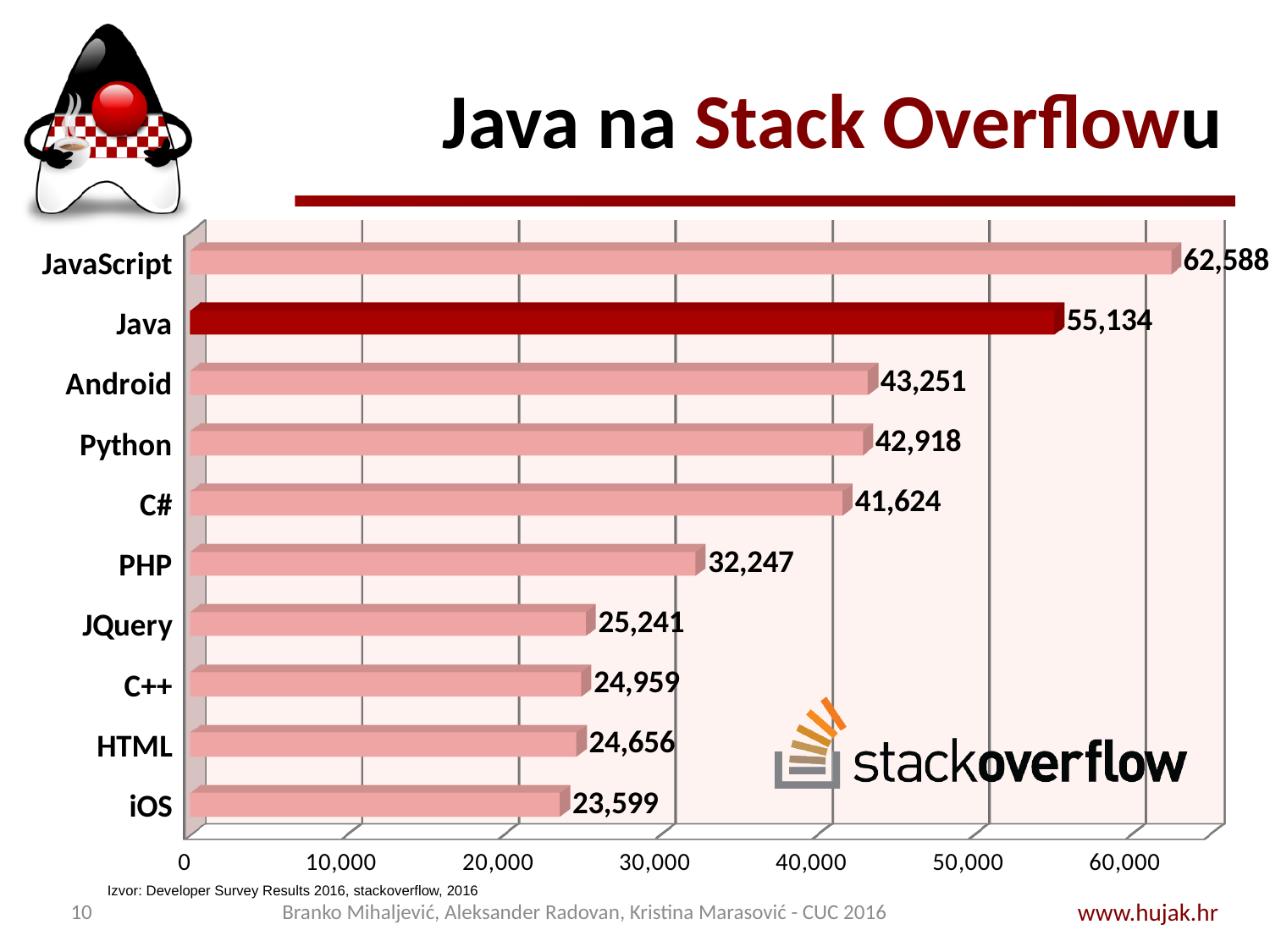
What is the value for Python? 42,918 Which category has the highest value? JavaScript What is the value for iOS? 23,599 Is the value for HTML greater or less than 20,000? greater Which bar is highlighted in a darker red colour than the others? Java What kind of chart is shown on the slide? bar chart Which is larger, the value for C# or the value for PHP? C# Which category has the lowest value? iOS What is the value for Java? 55,134 How many categories are shown in the chart? 10 What is the difference between the values for Android and PHP? 11,004 What is the difference between the values for JavaScript and Java? 7,454